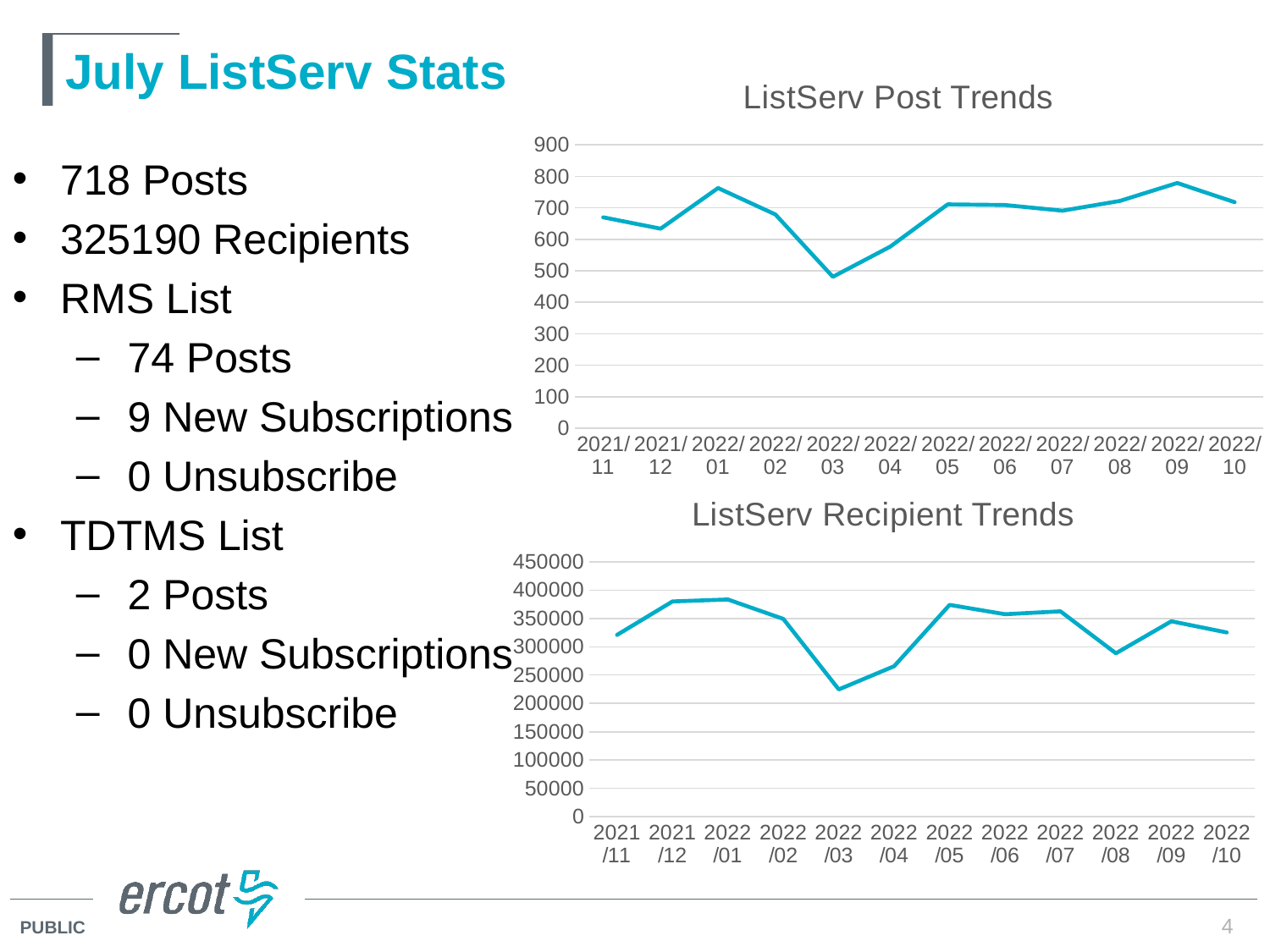
What kind of chart is the 'ListServ Post Trends' chart? line chart On the 'ListServ Recipient Trends' chart, which is larger, the value for 2022/08 or the value for 2022/09? 2022/09 On the 'ListServ Post Trends' chart, do the values rise or fall from 2022/03 to 2022/05? rise On the 'ListServ Post Trends' chart, which is larger, the value for 2022/01 or the value for 2022/03? 2022/01 On the 'ListServ Post Trends' chart, is the value for 2022/03 greater or less than 500? less On the 'ListServ Recipient Trends' chart, is the value for 2022/05 greater or less than 350000? greater On the 'ListServ Post Trends' chart, is the value for 2022/01 greater or less than 700? greater What is the title of the lower chart on the slide? ListServ Recipient Trends On the 'ListServ Recipient Trends' chart, which month has the lowest value? 2022/03 On the 'ListServ Post Trends' chart, which month has the lowest value? 2022/03 How many data points are plotted on the 'ListServ Recipient Trends' chart? 12